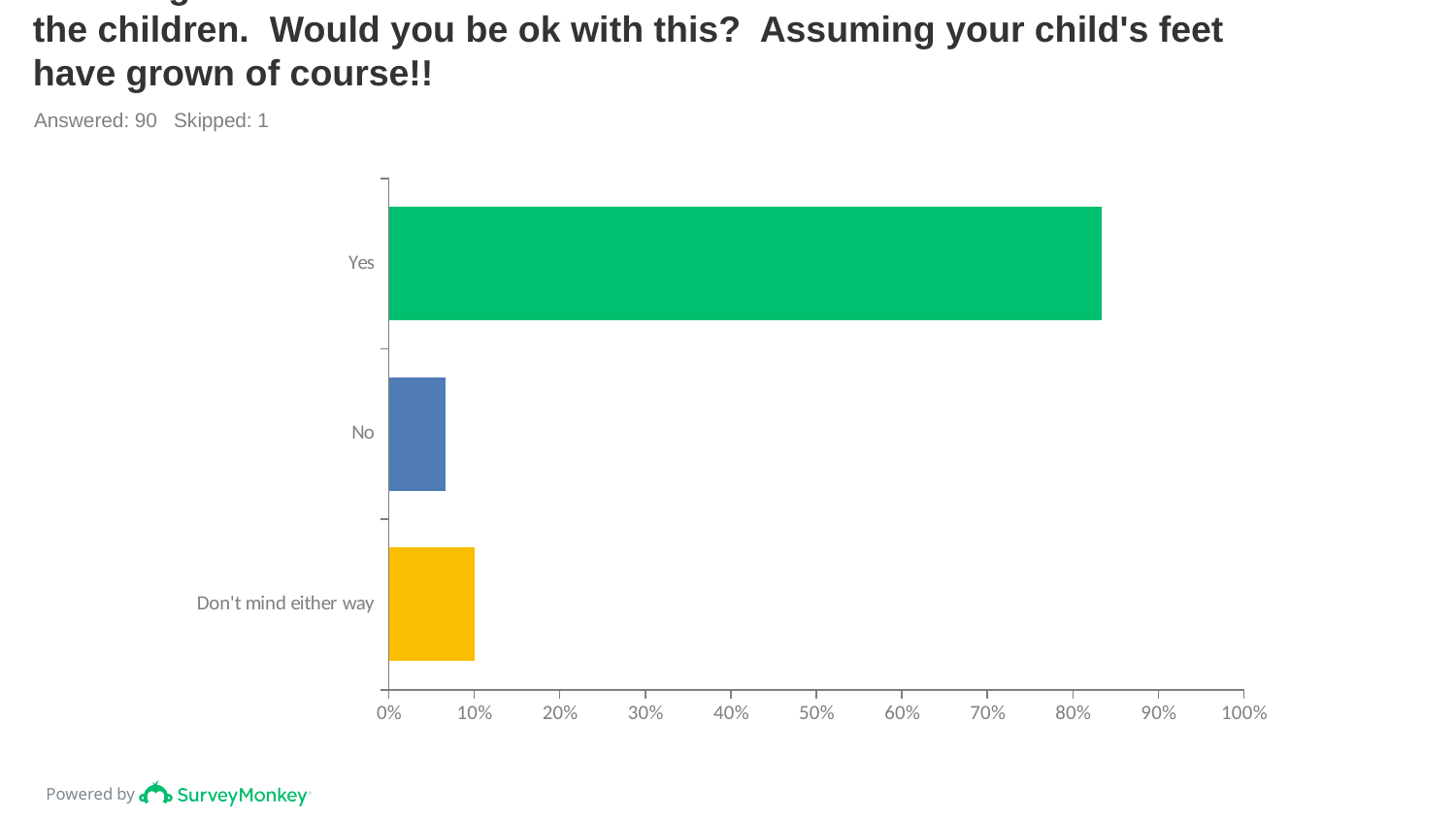
How many response categories are shown in the chart? 3 Which response category has the highest value? Yes Is the value for Yes greater or less than 50%? greater What kind of chart is shown on the slide? bar chart Which is larger, the value for Yes or the value for No? Yes Is the value for Yes greater or less than 80%? greater Which response category has the lowest value? No Is the value for No greater or less than 10%? less What is the highest percentage shown on the x axis? 100% Which is larger, the value for No or the value for Don't mind either way? Don't mind either way What colour is the bar for Yes? green